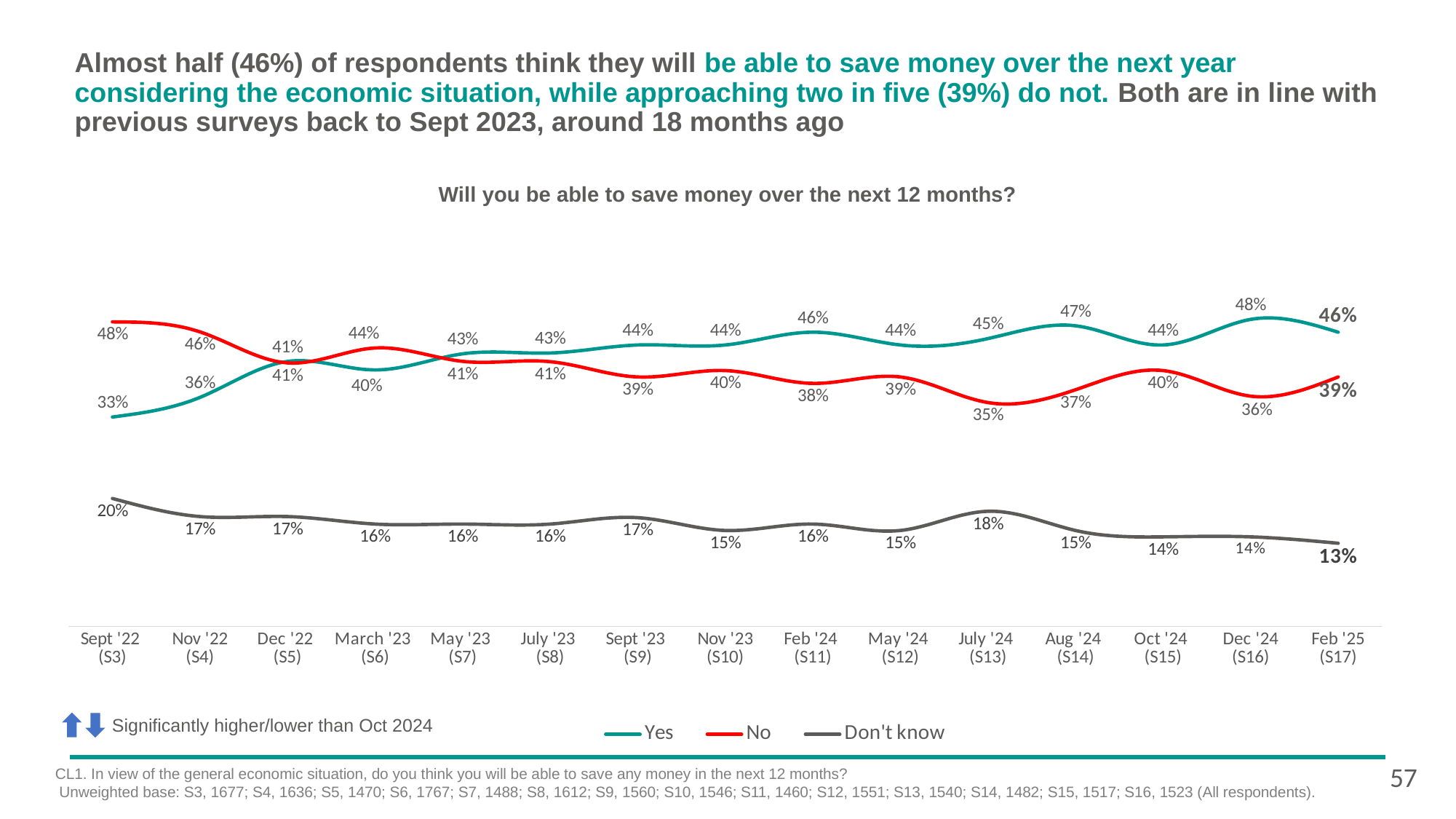
Does the 'Don't know' line generally rise or fall from Sept '22 to Feb '25? Fall What was the 'No' value in July '24 (S13)? 35% In Sept '22 (S3), which was larger: 'Yes' or 'No'? No In which survey wave was the 'Yes' value highest? Dec '24 (S16) What was the 'Don't know' value in Sept '22 (S3)? 20% What is the difference between the 'Yes' and 'No' values in Feb '25 (S17)? 7 percentage points How many survey waves are shown on the x axis? 15 In which survey wave was the 'Yes' value lowest? Sept '22 (S3) How many series does the legend list? 3 What percentage of respondents answered 'Yes' in Feb '25 (S17)? 46% In which survey wave was the 'Don't know' value lowest? Feb '25 (S17) What type of chart is shown? Line chart